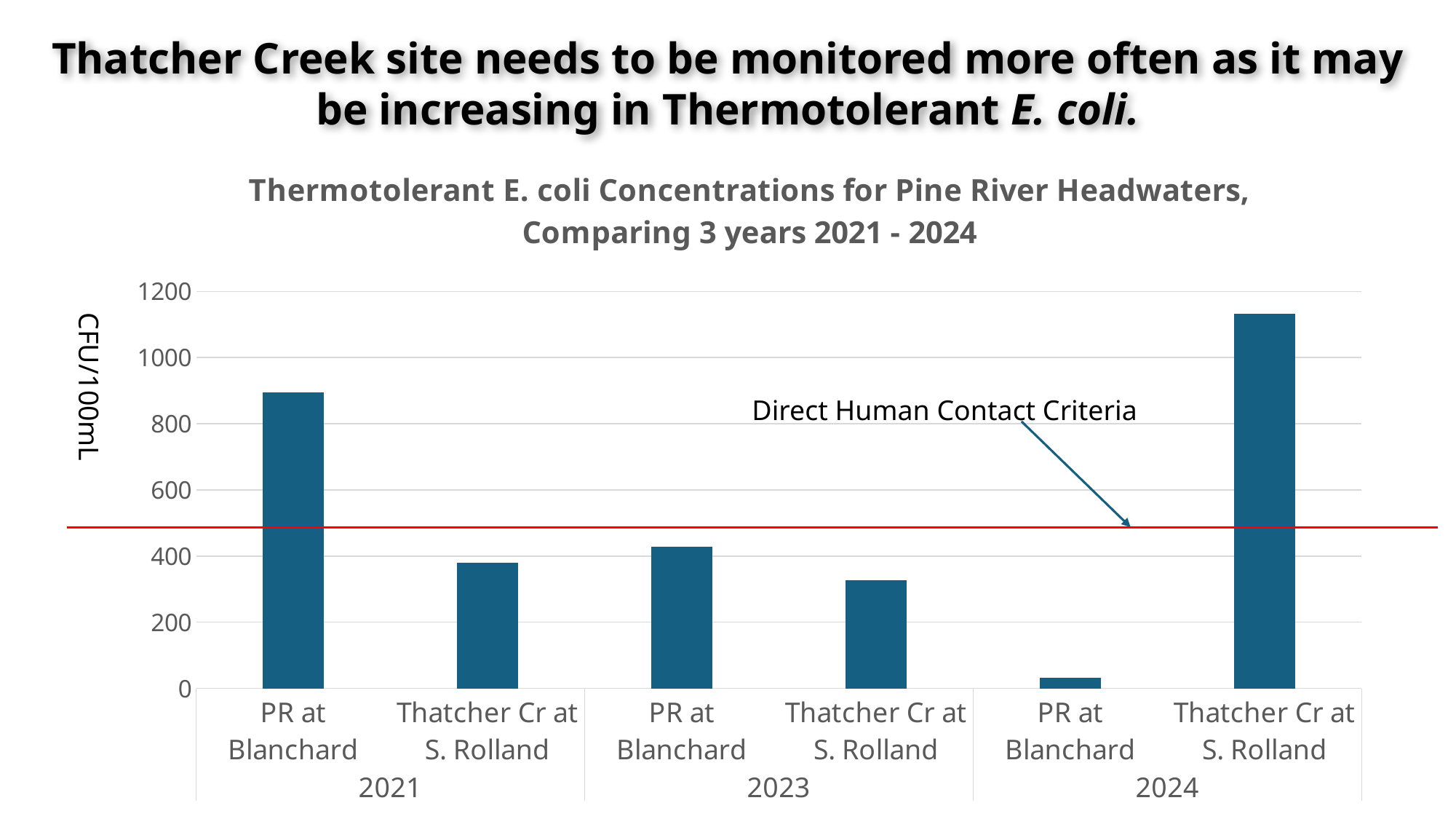
Do the values for PR at Blanchard rise or fall from 2021 to 2024? fall Which is larger: PR at Blanchard in 2021 or Thatcher Cr at S. Rolland in 2021? PR at Blanchard in 2021 Is the value for Thatcher Cr at S. Rolland in 2023 greater or less than 400? less How many bars are plotted in the chart? 6 What kind of chart is shown on the slide? bar chart What does the red horizontal line in the chart represent? Direct Human Contact Criteria Is the value for PR at Blanchard in 2024 greater or less than 200? less Is the value for PR at Blanchard in 2021 greater or less than 800? greater Which bar has the highest value in the chart? Thatcher Cr at S. Rolland, 2024 What is the label on the y axis of the chart? CFU/100mL Which bar has the lowest value in the chart? PR at Blanchard, 2024